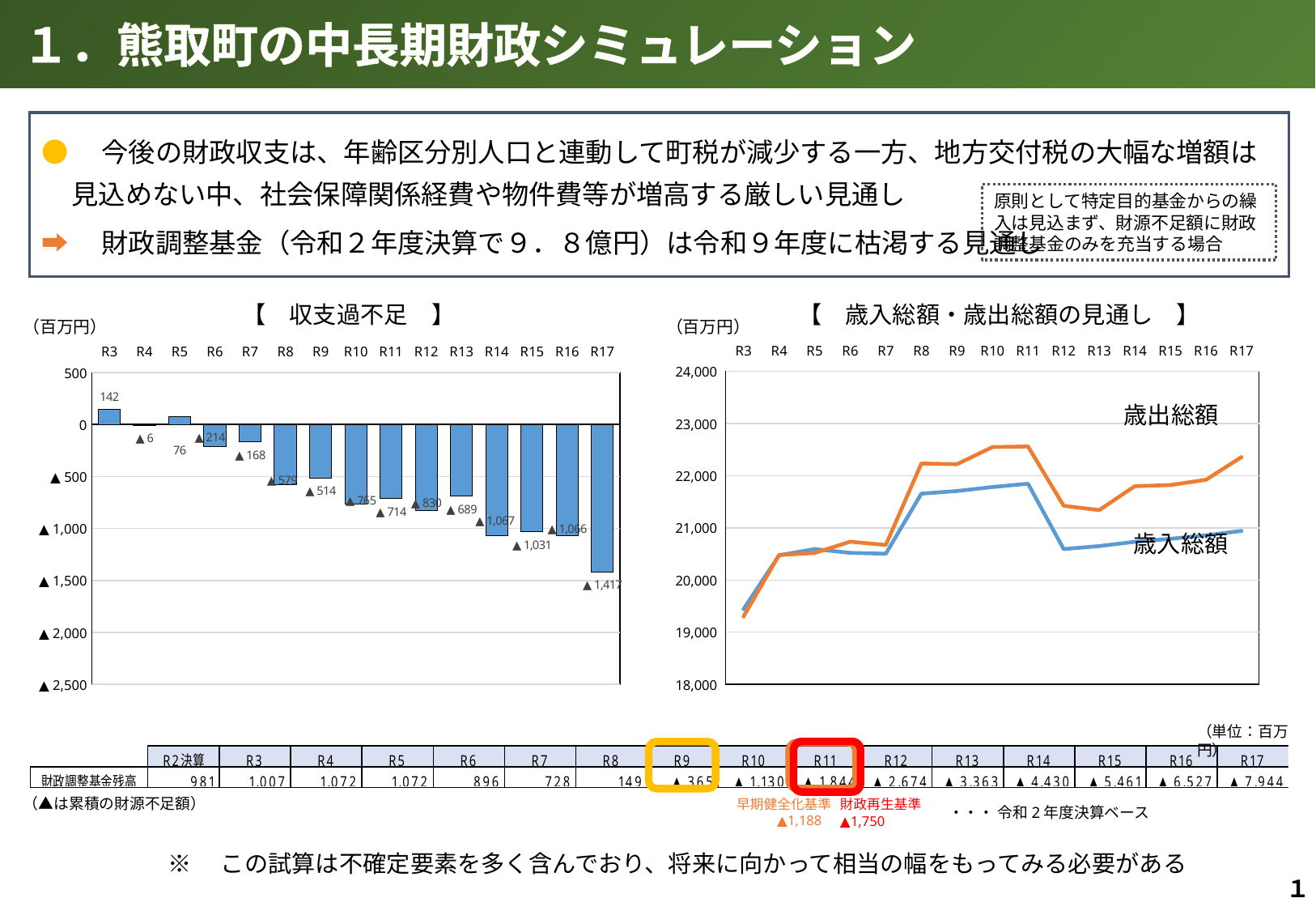
In the 歳入総額・歳出総額の見通し line chart on the right, is the 歳出総額 value for R11 greater or less than 22,000? greater In the 歳入総額・歳出総額の見通し line chart on the right, is the 歳入総額 value for R3 greater or less than 20,000? less In the 収支過不足 bar chart on the left, what is the value for R12? ▲830 In the 収支過不足 bar chart on the left, what is the value for R17? ▲1,417 In the 収支過不足 bar chart on the left, what is the difference between the values for R14 (▲1,067) and R13 (▲689)? 378 In the 歳入総額・歳出総額の見通し line chart on the right, which series is higher at R17, 歳出総額 or 歳入総額? 歳出総額 In the 収支過不足 bar chart on the left, which year has the highest (most positive) value? R3 In the 収支過不足 bar chart on the left, how many years are plotted on the x axis? 15 In the 歳入総額・歳出総額の見通し line chart on the right, how many series are plotted? 2 What kind of chart is the 収支過不足 chart on the left? Bar chart In the 収支過不足 bar chart on the left, what is the value for R3? 142 In the 収支過不足 bar chart on the left, which year has the lowest (most negative) value? R17